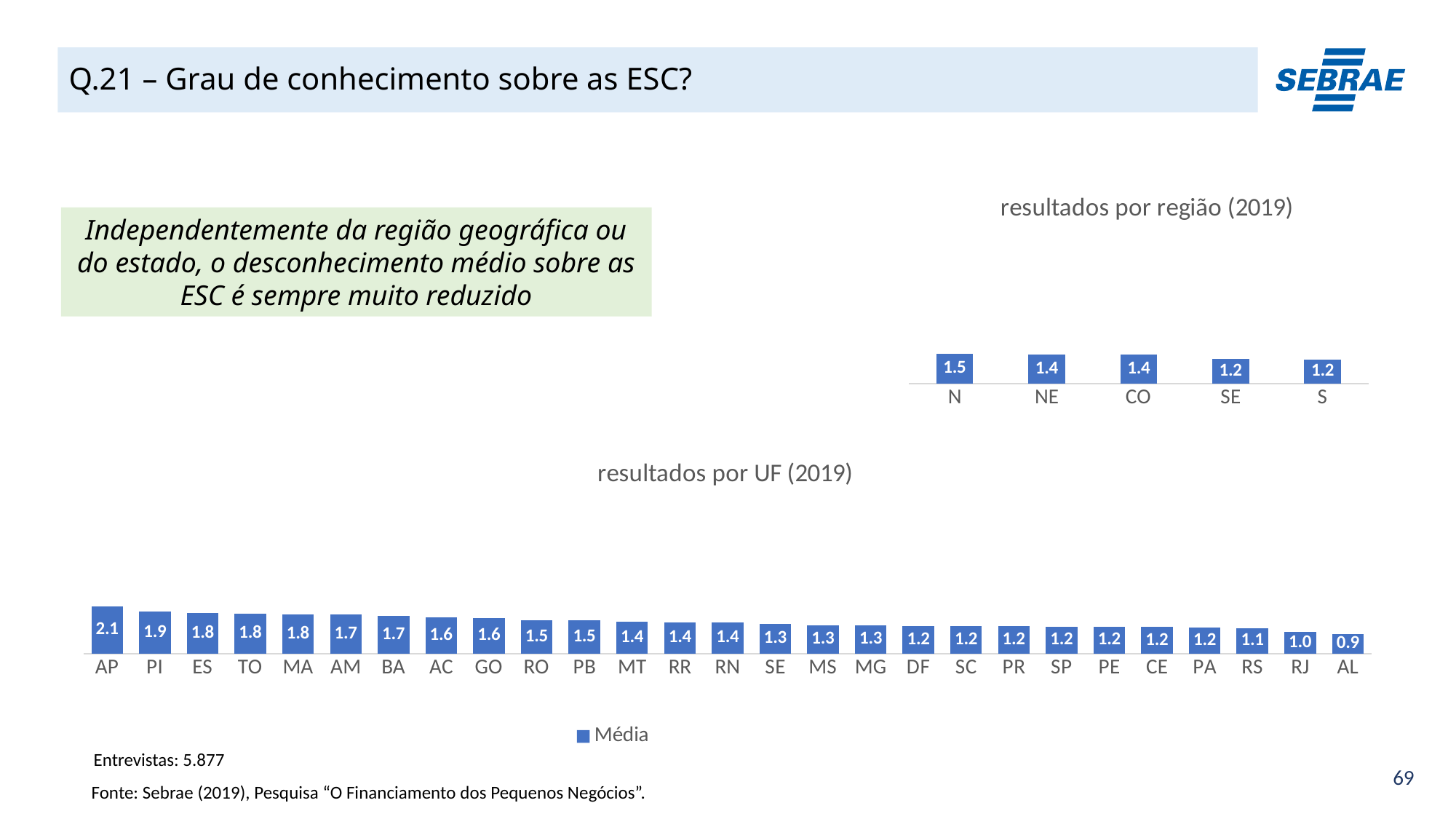
In the 'resultados por UF (2019)' chart, which is larger, the value for PI or the value for RS? PI In the 'resultados por região (2019)' chart, what is the value for N? 1.5 In the 'resultados por UF (2019)' chart, which UF has the highest value? AP In the 'resultados por região (2019)' chart, which region has the highest value? N In the 'resultados por UF (2019)' chart, what is the value for AP? 2.1 In the 'resultados por região (2019)' chart, how many regions are shown? 5 In the 'resultados por região (2019)' chart, what is the difference between the values for N and SE? 0.3 In the 'resultados por UF (2019)' chart, which UF has the lowest value? AL In the 'resultados por UF (2019)' chart, how many UFs are shown? 27 In the 'resultados por UF (2019)' chart, what is the value for RJ? 1.0 In the 'resultados por UF (2019)' chart, what is the difference between the values for AP and AL? 1.2 What series name does the legend of the 'resultados por UF (2019)' chart show? Média